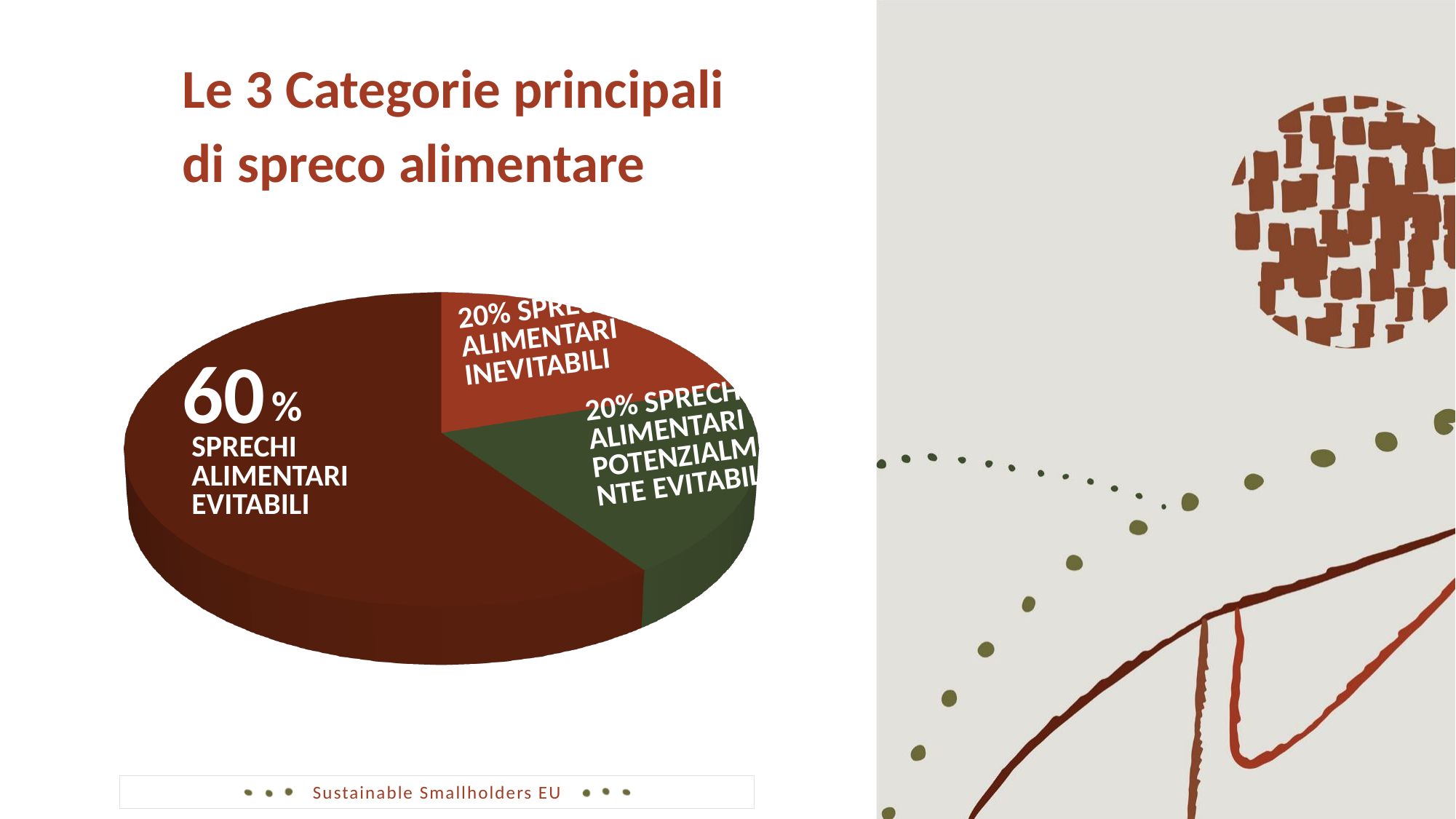
What is the combined share of the two 20% slices? 40% How many slices does the pie chart have? 3 What share of the pie is labelled "Sprechi alimentari inevitabili"? 20% What is the difference in percentage points between the "Sprechi alimentari evitabili" slice and the "Sprechi alimentari inevitabili" slice? 40 What share of the pie is labelled "Sprechi alimentari evitabili"? 60% Which category has the largest slice of the pie? Sprechi alimentari evitabili What is the title of the slide containing the pie chart? Le 3 Categorie principali di spreco alimentare What kind of chart is shown on the slide? pie chart What colour is the slice for "Sprechi alimentari potenzialmente evitabili"? green Which is larger: the "Sprechi alimentari evitabili" slice or the "Sprechi alimentari potenzialmente evitabili" slice? Sprechi alimentari evitabili Is the share for "Sprechi alimentari evitabili" greater or less than 50%? greater What share of the pie is labelled "Sprechi alimentari potenzialmente evitabili"? 20%